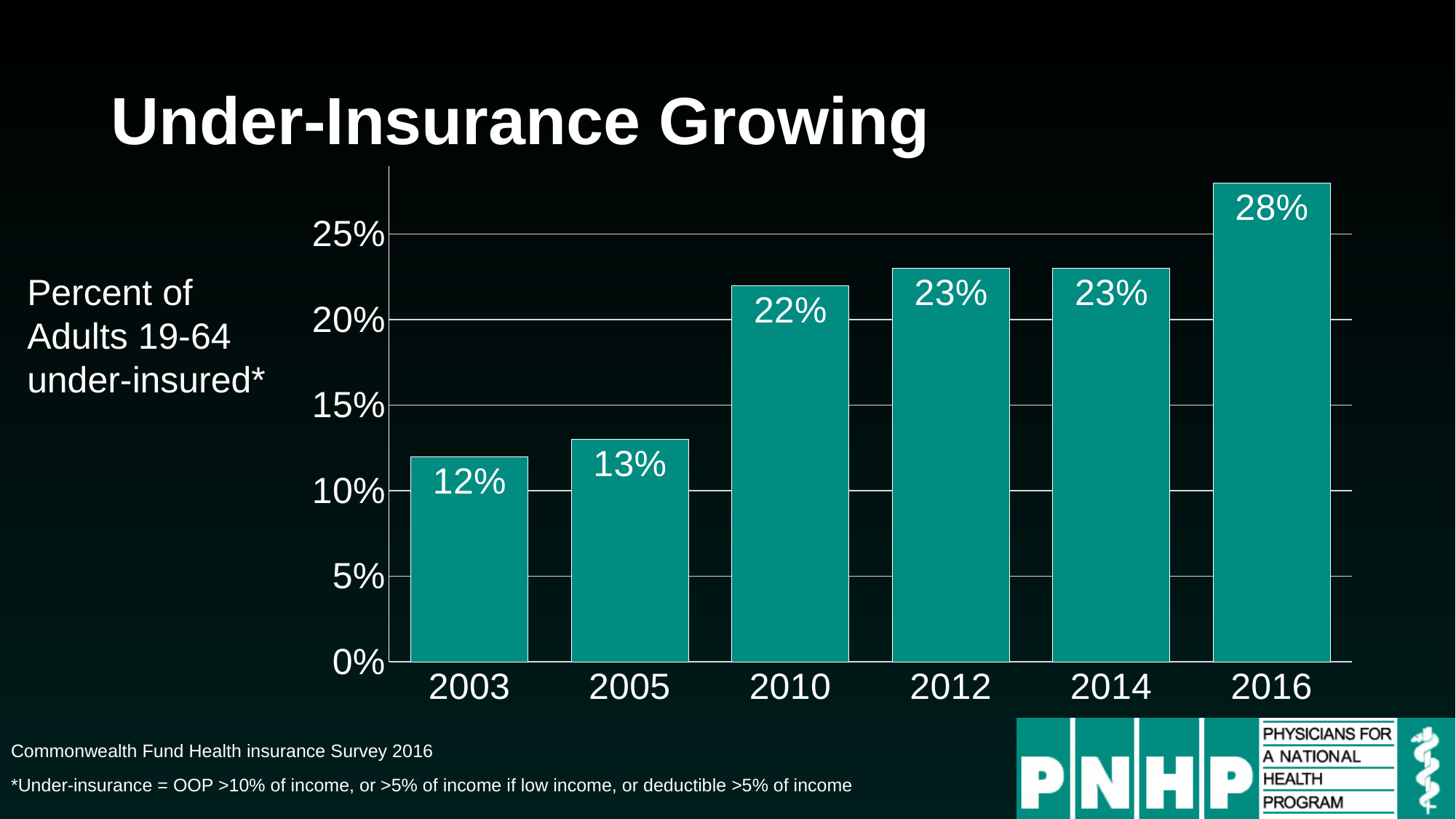
Do the values generally rise or fall from 2003 to 2016? rise How many years are shown on the x axis? 6 Is the value for 2016 greater or less than 25%? greater Which year has the highest percentage of under-insured adults? 2016 Which year has the lowest percentage of under-insured adults? 2003 What percent of adults 19-64 were under-insured in 2003? 12% What is the difference between the 2010 value and the 2005 value? 9% What kind of chart is shown on the slide? bar chart Which is larger, the value for 2005 or the value for 2012? 2012 What is the difference between the 2016 value and the 2003 value? 16% What is the value shown for 2010? 22% What is the value shown for 2016? 28%